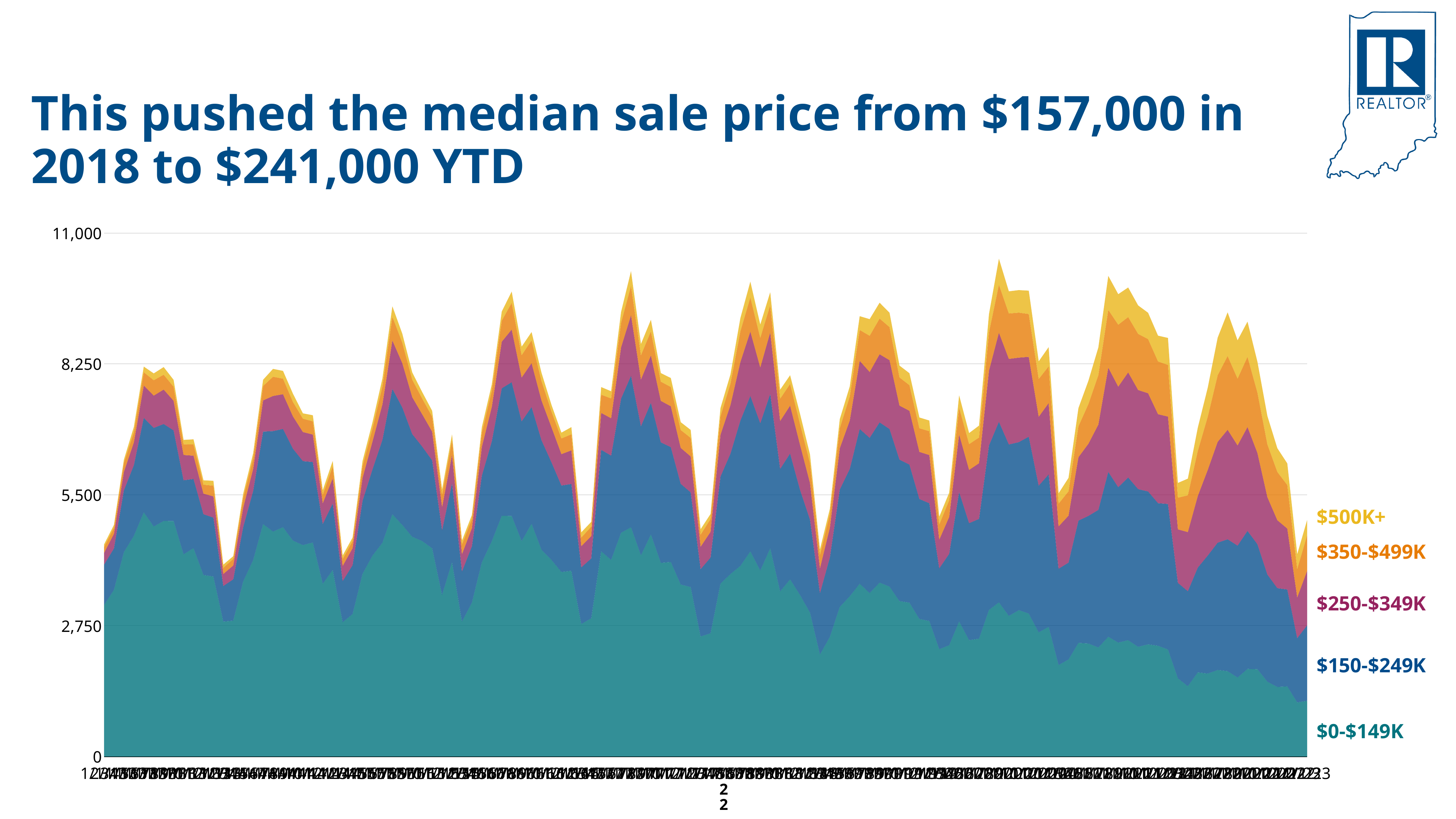
What is the highest value shown on the vertical axis? 11,000 Is the highest peak of the stacked total greater or less than 8,250? greater Which price-range series forms the top layer of the stacked chart? $500K+ How many price-range series are shown in the chart? 5 What kind of chart is shown on the slide? Stacked area chart Does the $500K+ band rise or fall over the course of the x axis? rise Is the lowest point of the stacked total greater or less than 2,750? greater Does the $0-$149K band rise or fall over the course of the x axis? fall Is the highest peak of the stacked total greater or less than 11,000? less Which price-range series forms the bottom layer of the stacked chart? $0-$149K According to the slide title, what was the median sale price in 2018? $157,000 According to the slide title, what is the median sale price YTD? $241,000